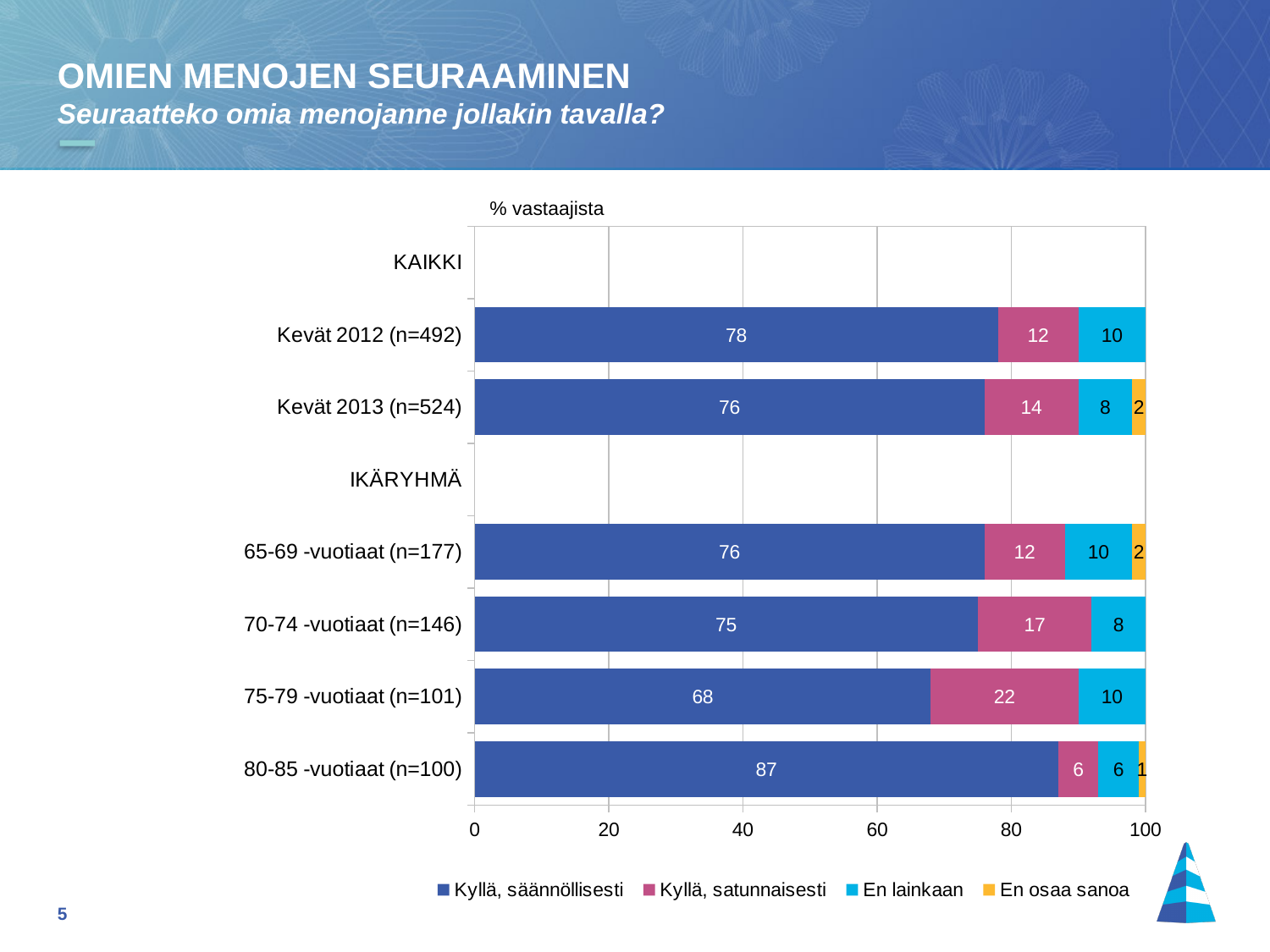
Which age group has the highest value for "Kyllä, säännöllisesti"? 80-85 -vuotiaat (n=100) What is the value of "Kyllä, satunnaisesti" for 75-79 -vuotiaat (n=101)? 22 What is the axis label shown above the chart? % vastaajista How many series does the legend list? 4 What kind of chart is shown on the slide? Stacked bar chart What is the difference between the "Kyllä, säännöllisesti" values for 80-85 -vuotiaat (n=100) and 75-79 -vuotiaat (n=101)? 19 What is the value of "En osaa sanoa" for 80-85 -vuotiaat (n=100)? 1 What is the total of the stacked bar for Kevät 2013 (n=524)? 100 What is the value of "Kyllä, säännöllisesti" for Kevät 2012 (n=492)? 78 Which is larger, the "Kyllä, satunnaisesti" value for 70-74 -vuotiaat (n=146) or for 65-69 -vuotiaat (n=177)? 70-74 -vuotiaat (n=146) What is the value of "En lainkaan" for Kevät 2013 (n=524)? 8 Which age group has the lowest value for "Kyllä, säännöllisesti"? 75-79 -vuotiaat (n=101)